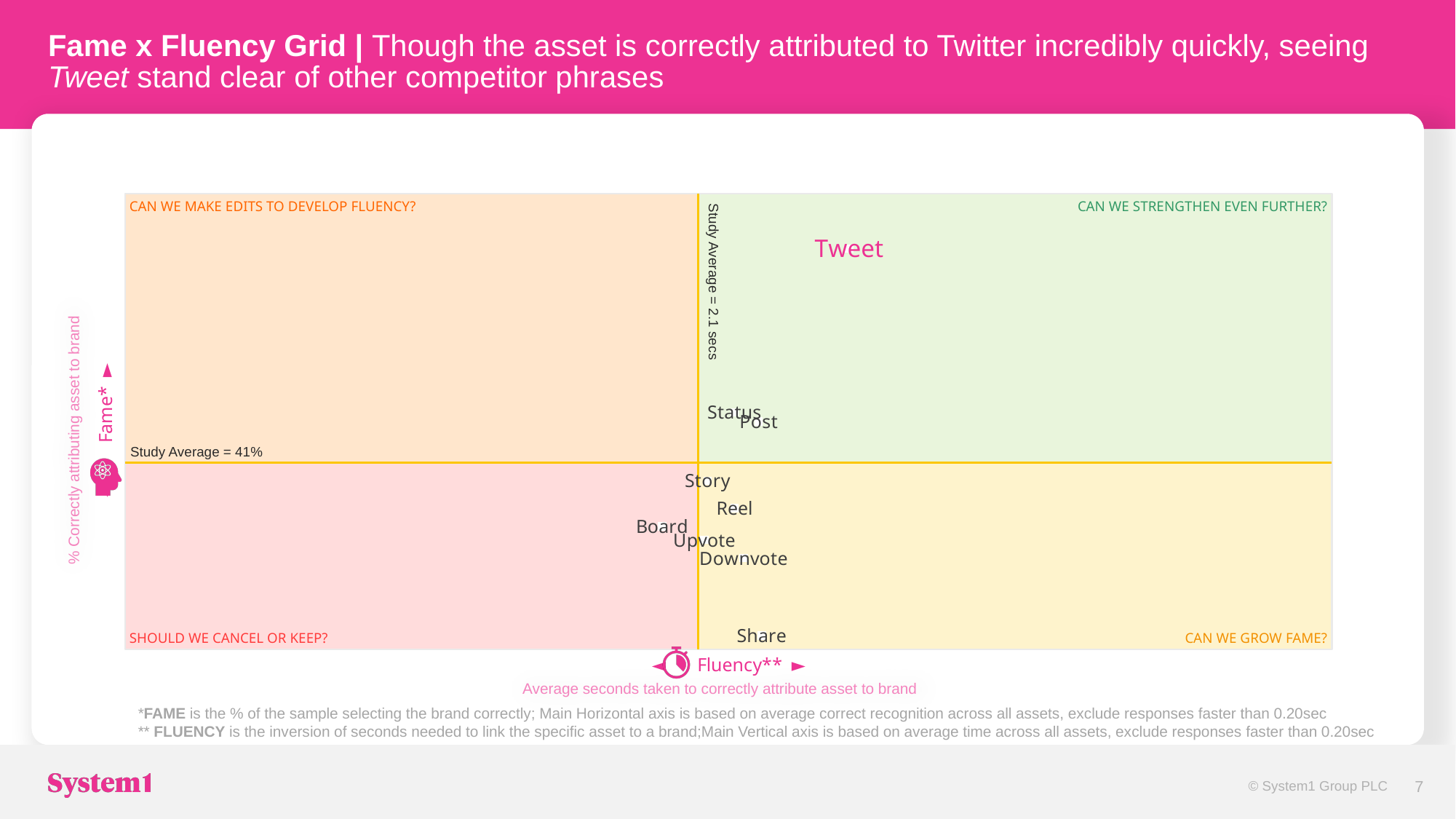
What is the Study Average for Fluency shown on the vertical reference line? 2.1 secs How many points lie above the 41% Fame study average line? 3 What kind of chart is shown on the slide? Scatter chart (quadrant grid) Which point is lowest on the Fame (vertical) axis? Share Which point is furthest to the left on the Fluency (horizontal) axis? Board Which point is furthest to the right on the Fluency (horizontal) axis? Tweet Which has the higher Fame value, Status or Story? Status Which quadrant label appears in the top-right quadrant where Tweet is plotted? CAN WE STRENGTHEN EVEN FURTHER? Which point is highest on the Fame (vertical) axis? Tweet Is the Fame value for Share greater or less than the 41% study average? less How many labelled data points are plotted on the Fame x Fluency grid? 9 What is the Study Average for Fame shown on the horizontal reference line? 41%